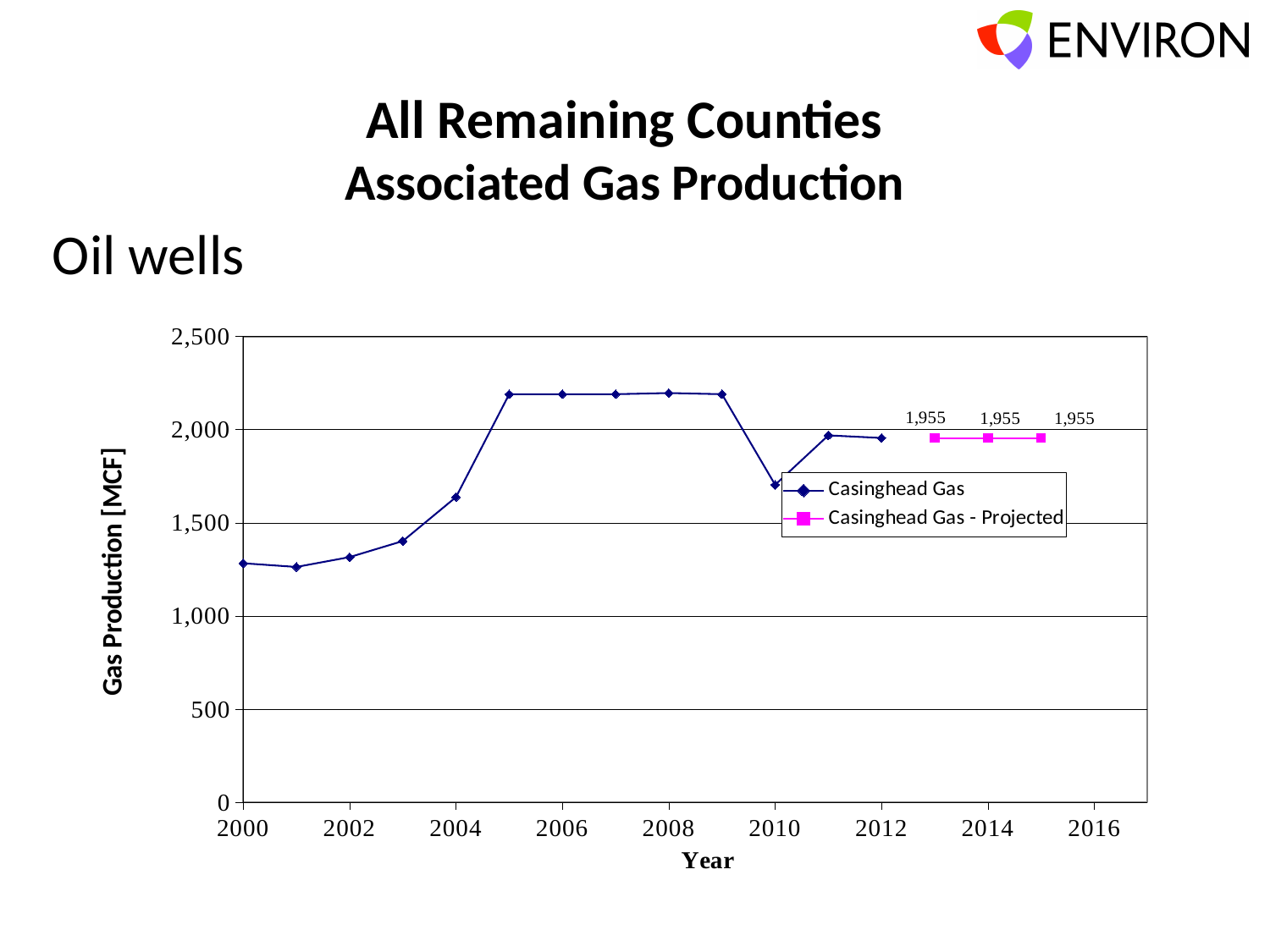
Is the Casinghead Gas value for 2005 greater or less than 2,000? greater Is the Casinghead Gas value for 2010 greater or less than 2,000? less Is the Casinghead Gas value for 2000 greater or less than 1,500? less Which year has the larger Casinghead Gas value, 2003 or 2004? 2004 What is the projected Casinghead Gas value for 2015? 1,955 How many series does the legend list? 2 Does the Casinghead Gas value rise or fall from 2001 to 2005? rise Which year has the larger Casinghead Gas value, 2005 or 2010? 2005 What is the projected Casinghead Gas value for 2014? 1,955 How many data points does the Casinghead Gas - Projected series have? 3 What is the title of the y axis? Gas Production [MCF] What kind of chart is shown on the slide? line chart